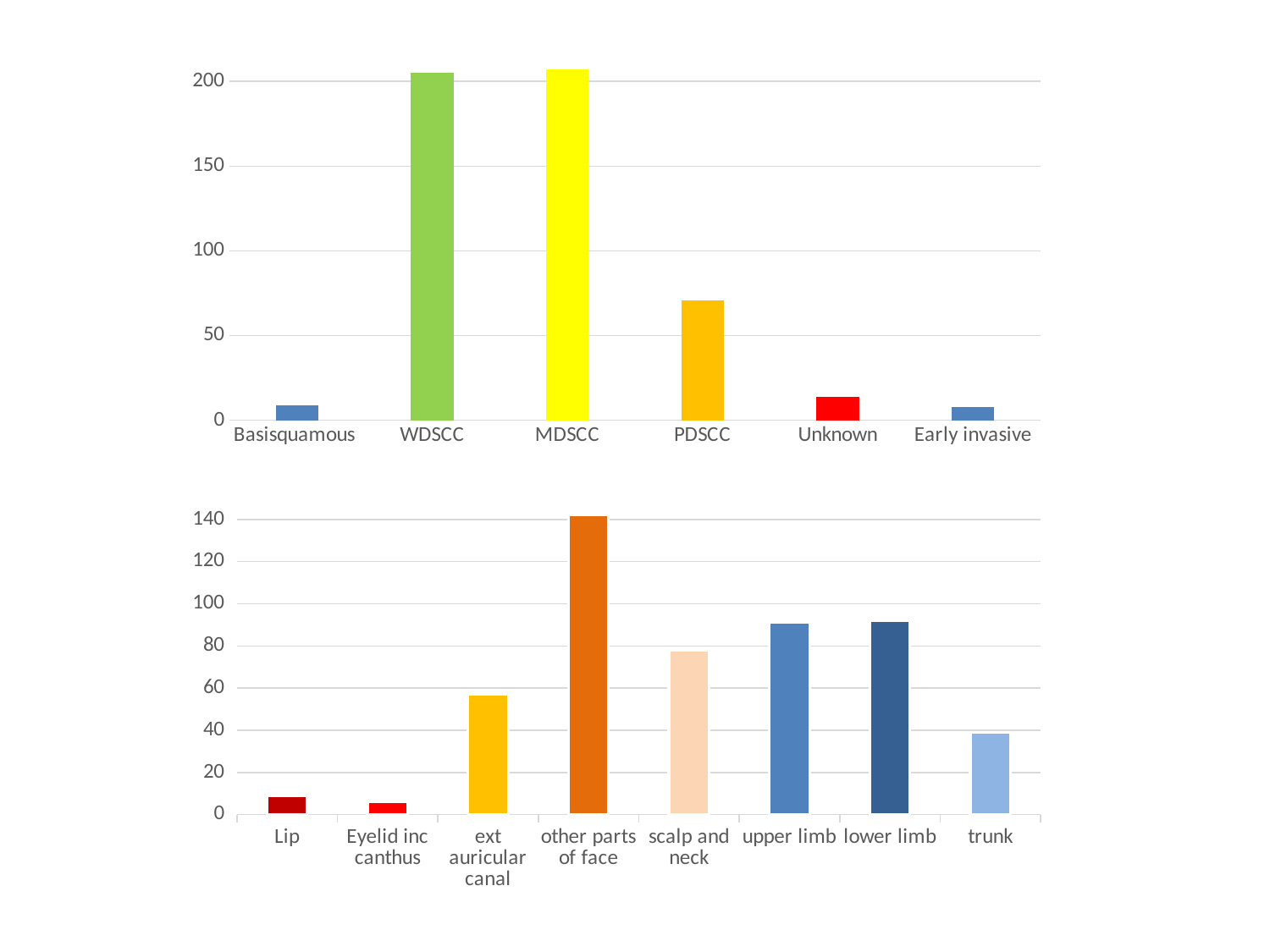
In the bottom chart, is the value for scalp and neck greater or less than 60? greater In the top chart, is the value for Unknown greater or less than 50? less In the top chart, is the value for PDSCC greater or less than 50? greater How many categories are shown on the x axis of the bottom chart? 8 What kind of chart is the top chart on the slide? bar chart In the top chart, which is larger, the value for PDSCC or the value for Unknown? PDSCC What kind of chart is the bottom chart on the slide? bar chart In the bottom chart, which is larger, the value for other parts of face or the value for scalp and neck? other parts of face How many categories are shown on the x axis of the top chart? 6 In the bottom chart, which category has the highest value? other parts of face